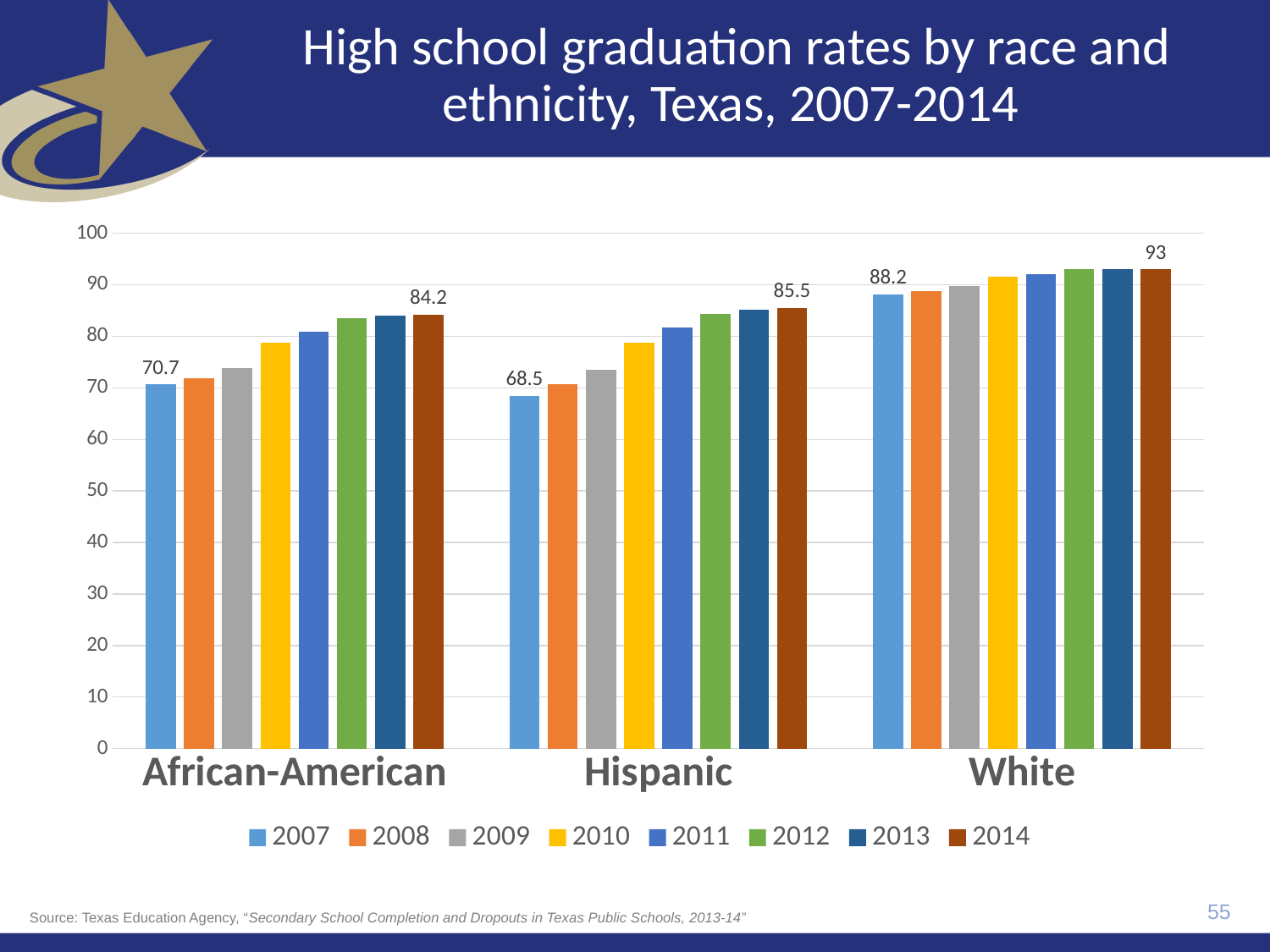
What was the high school graduation rate for Hispanic students in 2014? 85.5 Do the graduation rates for Hispanic students rise or fall from 2007 to 2014? Rise How many years (series) does the legend list? 8 What type of chart is shown on the slide? Bar chart By how many points did the African-American graduation rate increase from 2007 to 2014? 13.5 What was the high school graduation rate for African-American students in 2007? 70.7 What is the difference between the White and Hispanic graduation rates in 2014? 7.5 Which race/ethnicity group had the lowest graduation rate in 2007? Hispanic Which race/ethnicity group had the highest graduation rate in 2014? White Is the 2010 graduation rate for Hispanic students greater or less than 80? less Which was larger in 2007: the graduation rate for White students or for African-American students? White What was the high school graduation rate for White students in 2014? 93